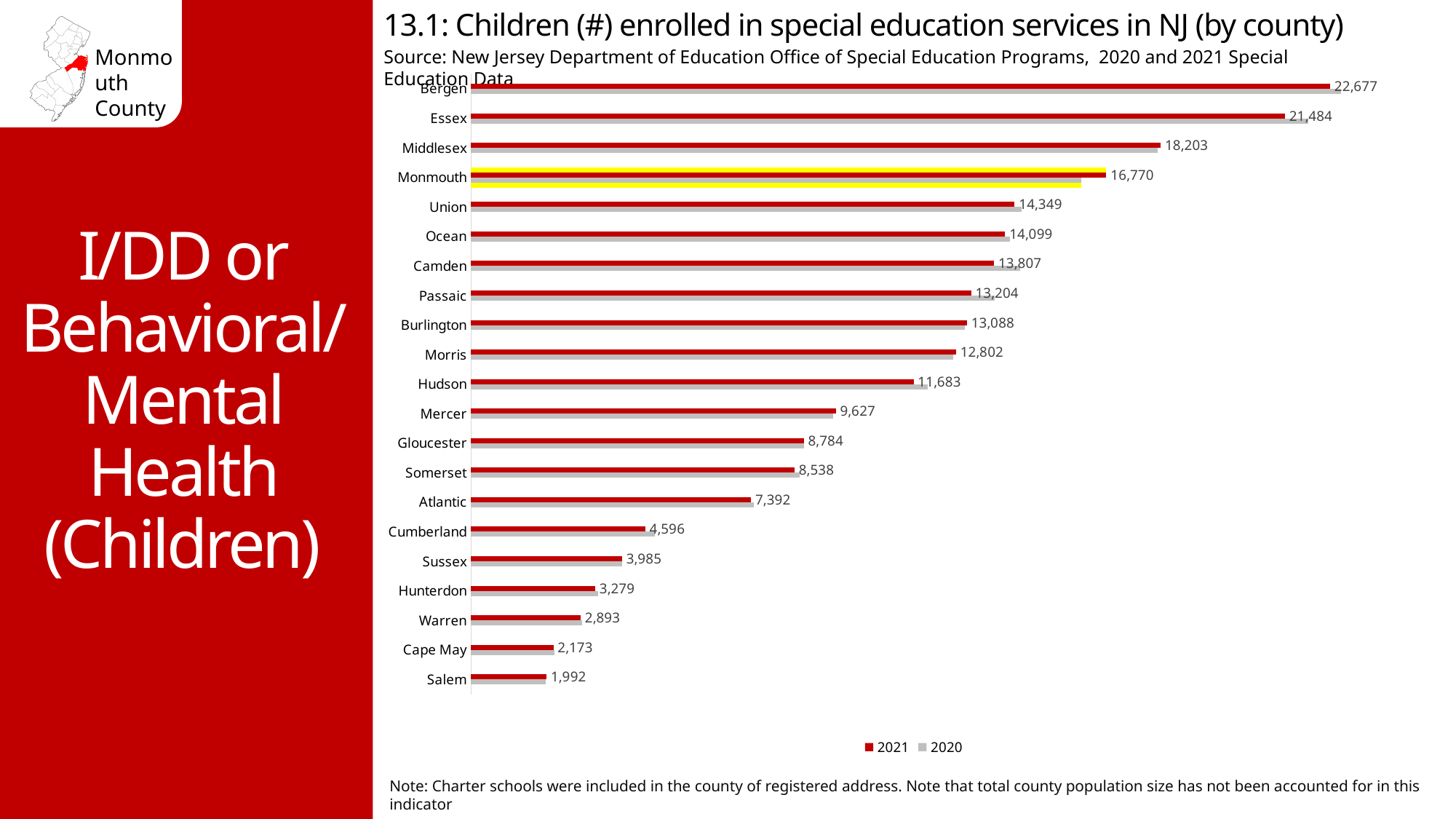
How many series does the legend list? 2 What is the 2021 value for Salem County? 1,992 What type of chart is shown on the slide? Bar chart What is the difference between the 2021 values for Bergen and Essex? 1,193 Which county has the highest number of children enrolled in special education services in 2021? Bergen How many counties are shown in the chart? 21 Which county has a larger 2021 value, Ocean or Camden? Ocean What is the difference between the 2021 values for Monmouth and Union? 2,421 Which county has the lowest number of children enrolled in special education services in 2021? Salem What is the 2021 value for Hudson County? 11,683 What is the 2021 value for Monmouth County? 16,770 What is the 2021 value for Bergen County? 22,677